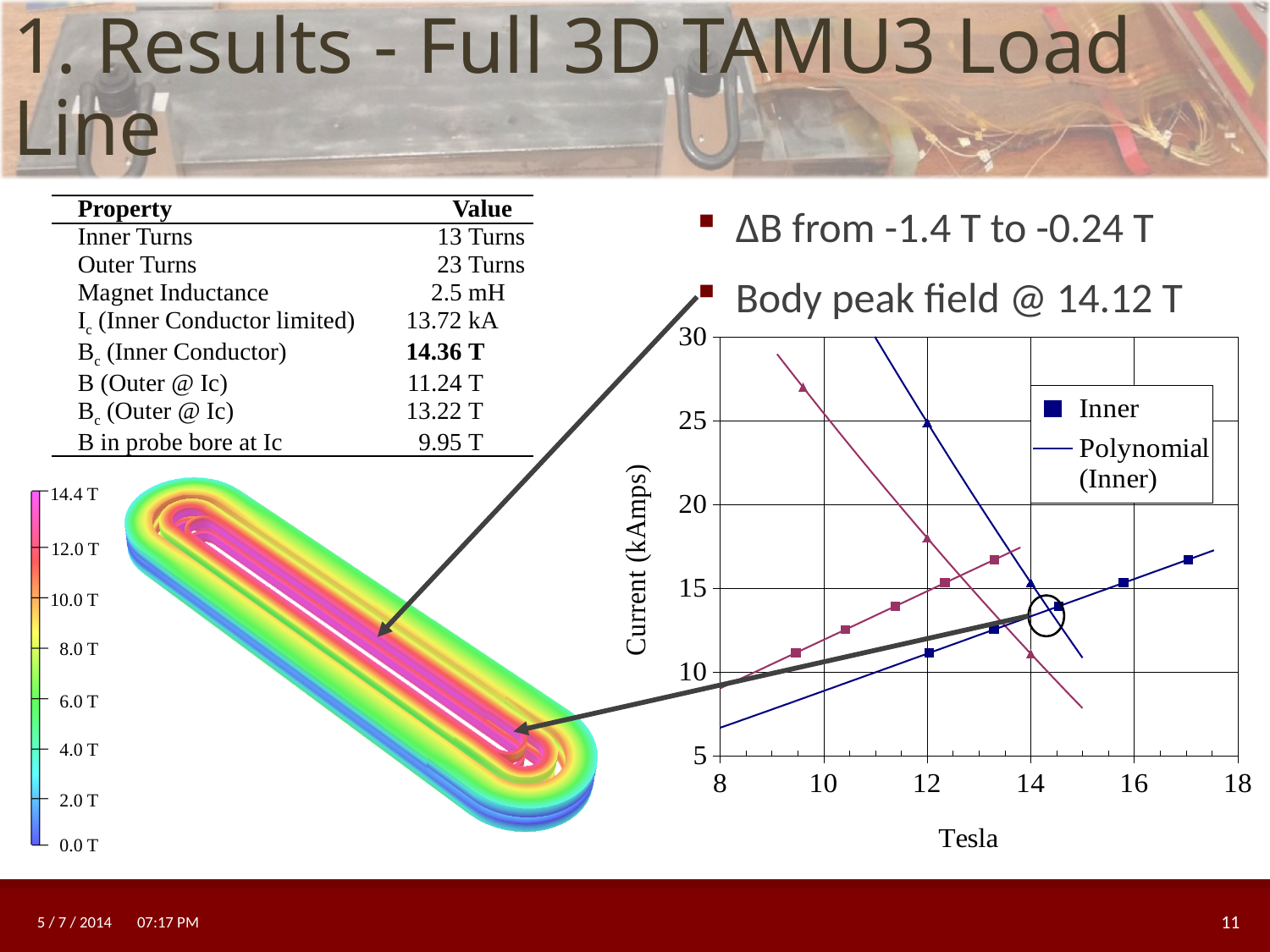
Do the values of the Inner series (blue squares) rise or fall as Tesla increases along the x axis? rise What kind of chart is shown on the slide? scatter chart with lines How many series does the chart's legend list? 2 What is the label of the y axis of the chart? Current (kAmps) Is the current for the Inner series (blue square) at 17 Tesla greater or less than 20 kAmps? less Is the current for the Inner series (blue square) at 12 Tesla greater or less than 15 kAmps? less Which of the two Inner series points (blue squares) has the larger current: the one at 12 Tesla or the one at 17 Tesla? 17 Tesla Is the current for the Inner series (blue square) at 17 Tesla greater or less than 15 kAmps? greater What is the label of the x axis of the chart? Tesla What is the highest value shown on the y axis of the chart? 30